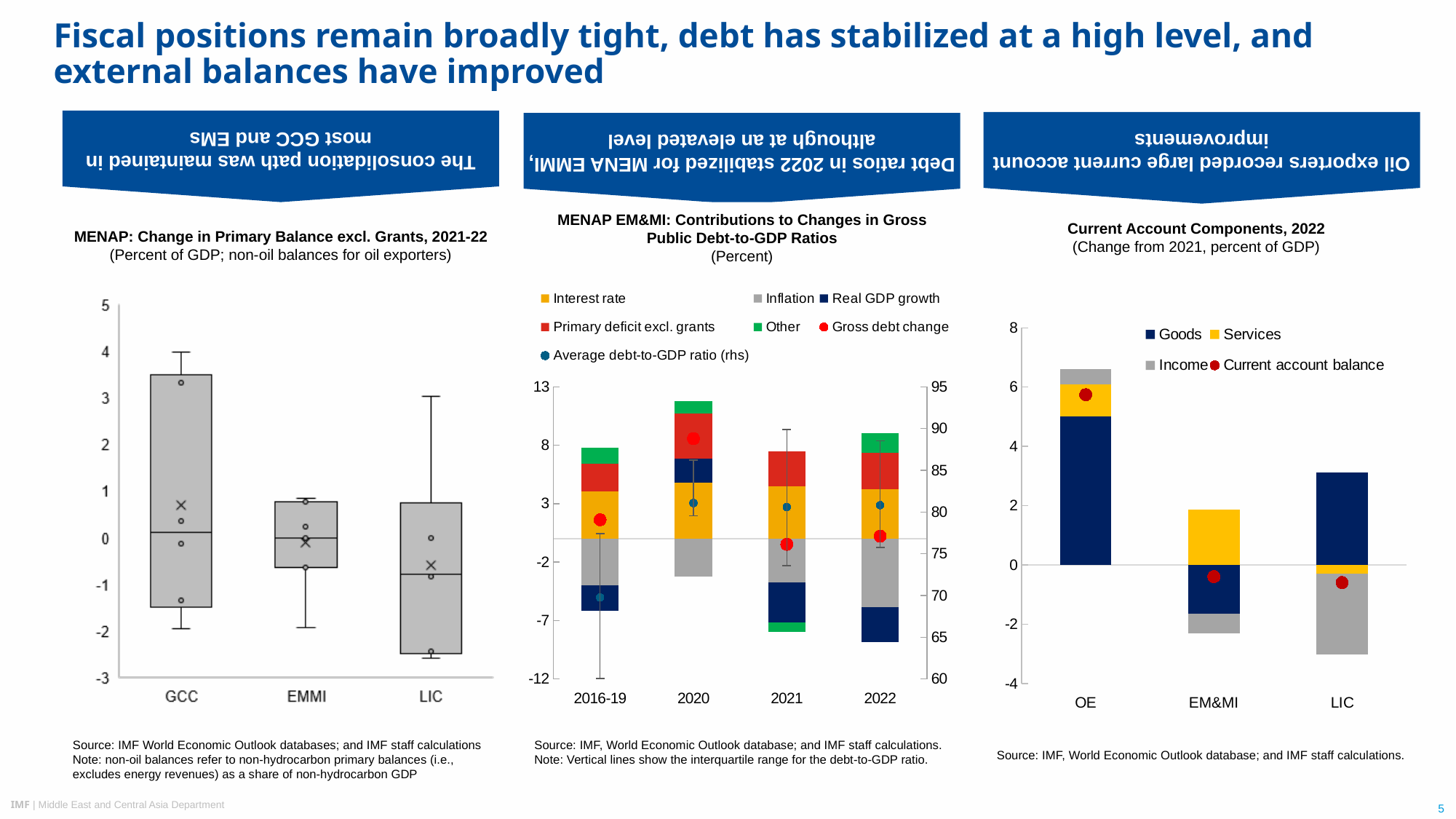
On the right chart (Current Account Components, 2022), is the current account balance for EM&MI greater or less than 0? less On the right chart (Current Account Components, 2022), is the current account balance for OE greater or less than 4? greater On the left chart (MENAP: Change in Primary Balance excl. Grants, 2021-22), what kind of chart is it? box plot On the right chart (Current Account Components, 2022), how many entries does the legend list? 4 On the middle chart (MENAP EM&MI: Contributions to Changes in Gross Public Debt-to-GDP Ratios), how many entries does the legend list? 7 On the right chart (Current Account Components, 2022), how many categories are shown on the x axis? 3 On the middle chart (MENAP EM&MI: Contributions to Changes in Gross Public Debt-to-GDP Ratios), is the average debt-to-GDP ratio (rhs) for 2016-19 greater or less than 75? less On the right chart (Current Account Components, 2022), which category has the highest current account balance? OE On the left chart (MENAP: Change in Primary Balance excl. Grants, 2021-22), which category has the lowest median? LIC On the middle chart (MENAP EM&MI: Contributions to Changes in Gross Public Debt-to-GDP Ratios), which period has the highest gross debt change? 2020